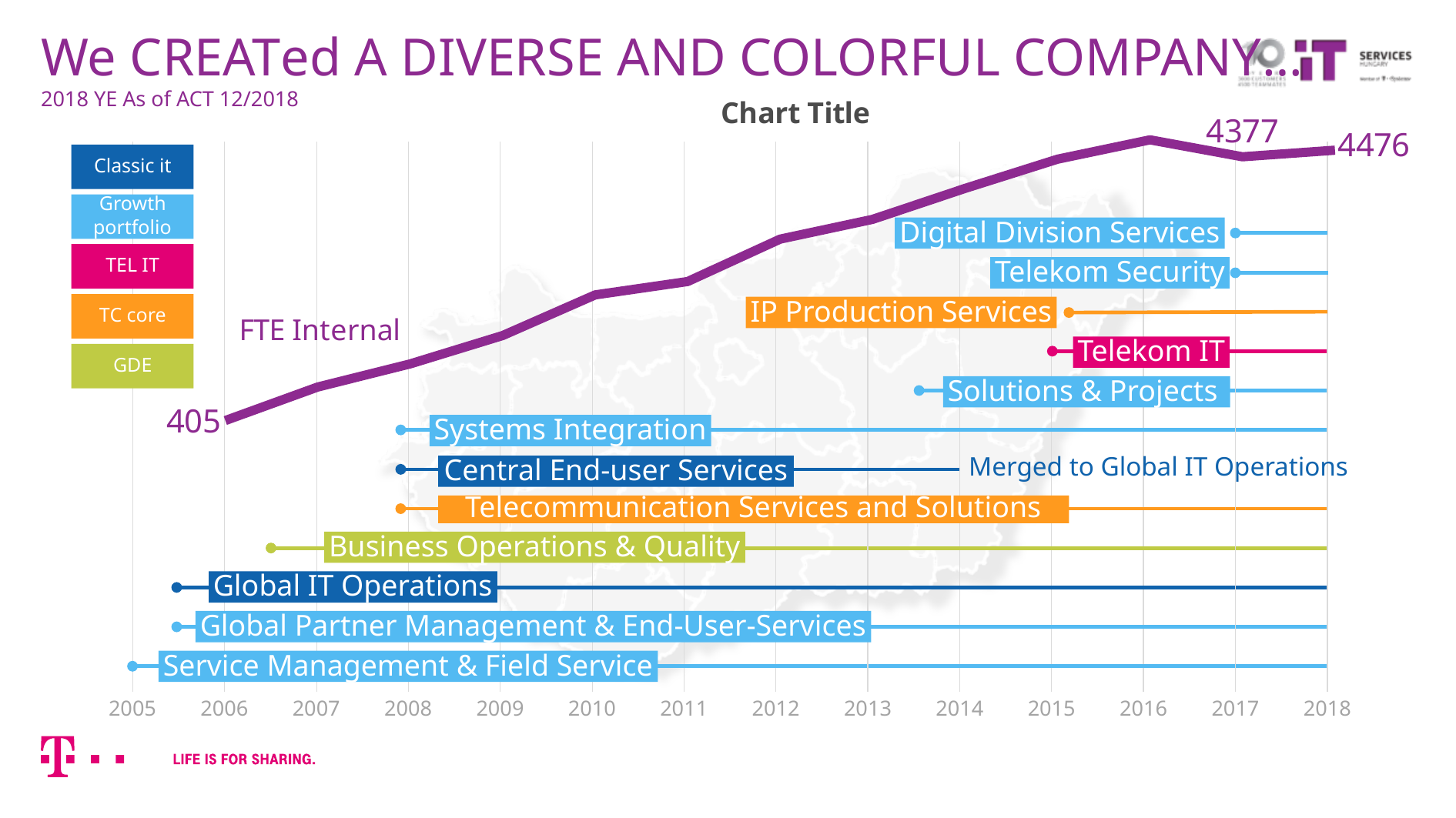
What is the FTE Internal value shown for 2017? 4377 By how much did FTE Internal change from 2017 to 2018? 99 Which year shows the lowest FTE Internal value on the line? 2006 How many categories are listed in the colour legend on the left (Classic it, Growth portfolio, etc.)? 5 What is the FTE Internal value shown for 2006? 405 Which year has the larger FTE Internal value, 2017 or 2018? 2018 What is the difference between the FTE Internal values for 2018 and 2006? 4071 What kind of chart is used to show FTE Internal on the slide? line chart Does the FTE Internal line generally rise or fall from 2006 to 2018? rise How many business unit timeline bars are shown below the FTE Internal line? 12 How many year labels are shown on the x axis? 14 What is the FTE Internal value shown for 2018? 4476